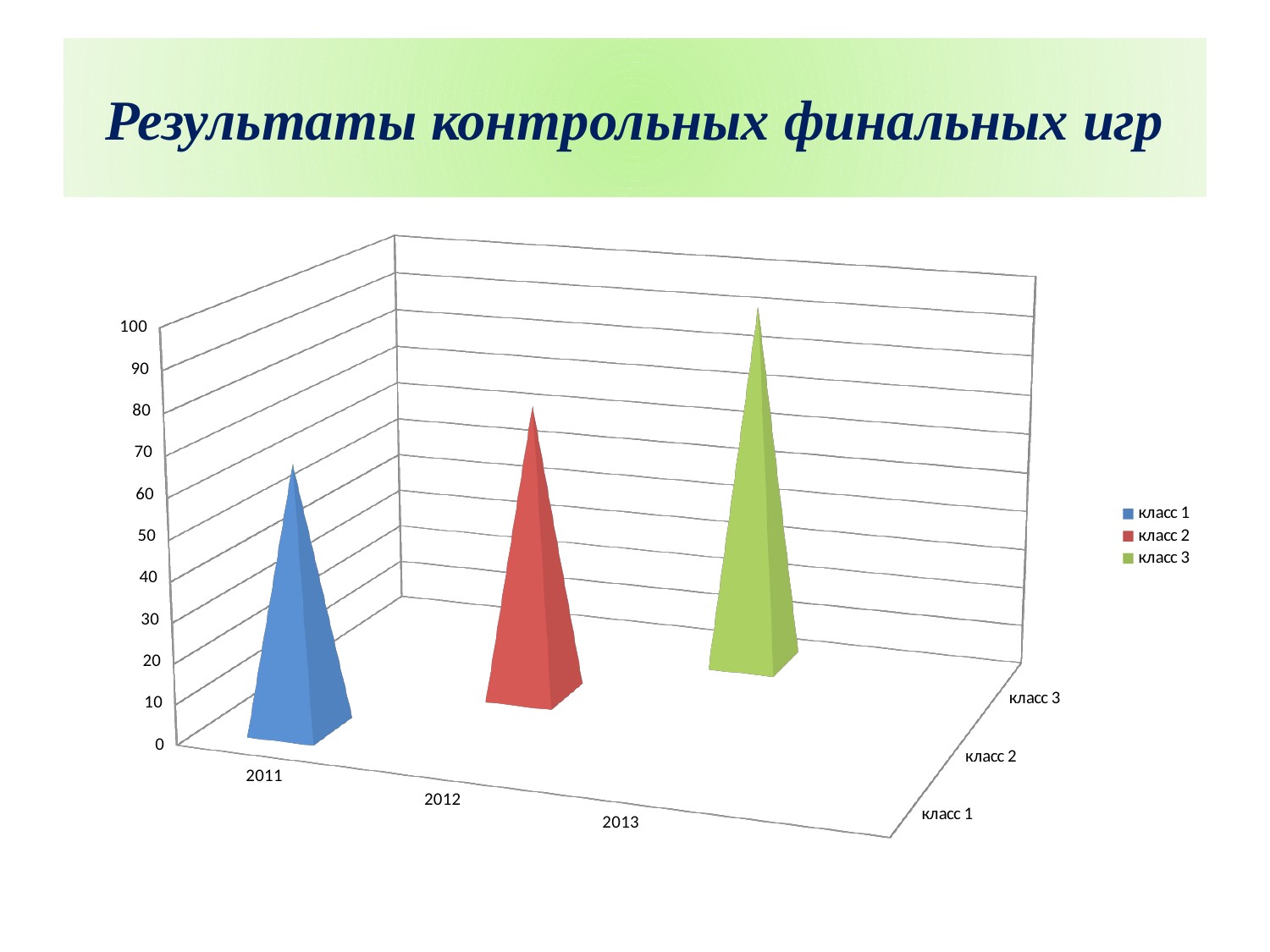
Is the value for 2011 greater or less than 90? less Do the bar heights rise or fall from 2011 to 2013? rise Which colour represents класс 3 in the legend? green What is the title of the chart on the slide? Результаты контрольных финальных игр What kind of chart is shown on the slide? bar chart Which is larger, the bar for 2012 or the bar for 2011? 2012 How many series does the legend list? 3 Which year has the highest bar? 2013 Which year has the lowest bar? 2011 How many year categories are shown on the x axis? 3 Which is larger, the bar for 2013 or the bar for 2012? 2013 Is the value for 2012 greater or less than 50? greater